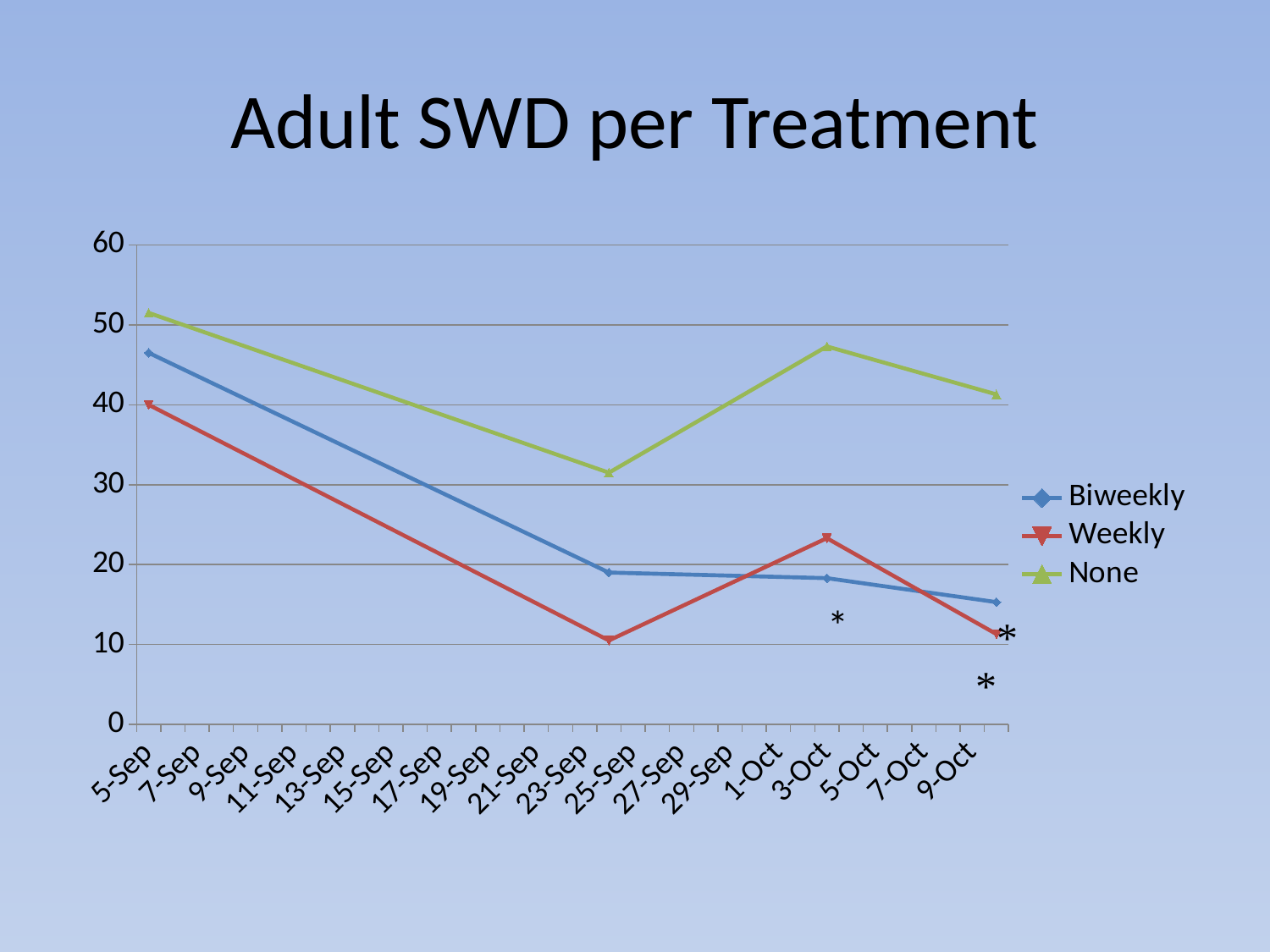
Is the value for the Weekly series on 5-Sep greater or less than 30? greater How many series does the legend list? 3 Which series has the highest value on 9-Oct? None Does the None series rise or fall from 5-Sep to 23-Sep? fall What is the title of the chart? Adult SWD per Treatment What kind of chart is shown on the slide? line chart Is the value for the Biweekly series on 5-Sep greater or less than 40? greater On 3-Oct, which series has the larger value, Weekly or Biweekly? Weekly Is the value for the None series on 3-Oct greater or less than 40? greater Which series has the lowest value on 23-Sep? Weekly What are the three series named in the legend? Biweekly, Weekly, None